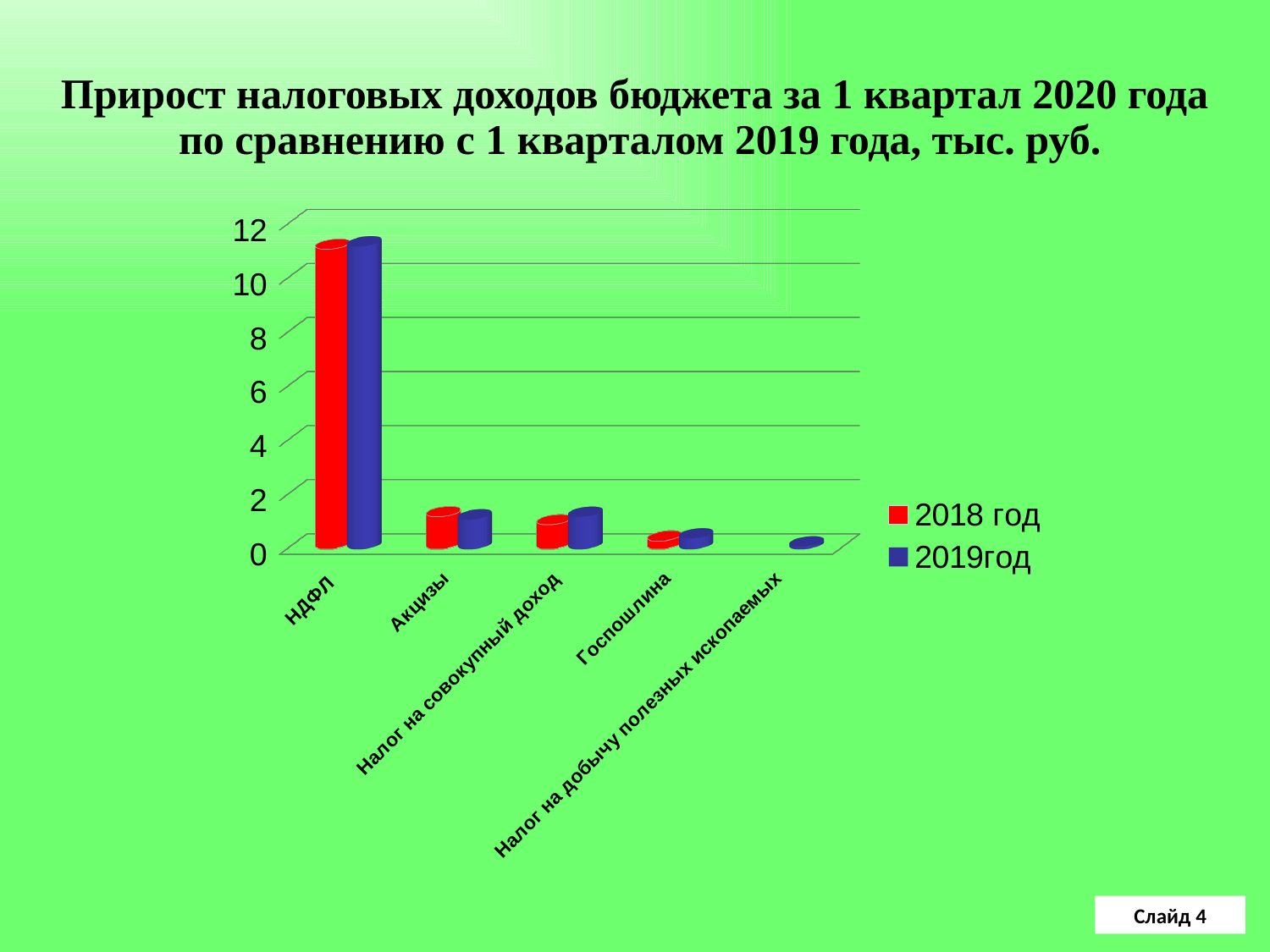
How many categories are shown on the x axis of the chart? 5 For the 2018 год series, which is larger: НДФЛ or Госпошлина? НДФЛ Which category has the highest value for the 2019год series? НДФЛ Is the 2019год value for Налог на совокупный доход greater or less than 4? less How many series does the legend list? 2 Which category has the highest value for the 2018 год series? НДФЛ Is the 2018 год value for НДФЛ greater or less than 10? greater What kind of chart is shown on the slide? bar chart What colour represents the 2018 год series in the chart? red Is the 2018 год value for Акцизы greater or less than 2? less Which category has the lowest value for the 2018 год series? Госпошлина